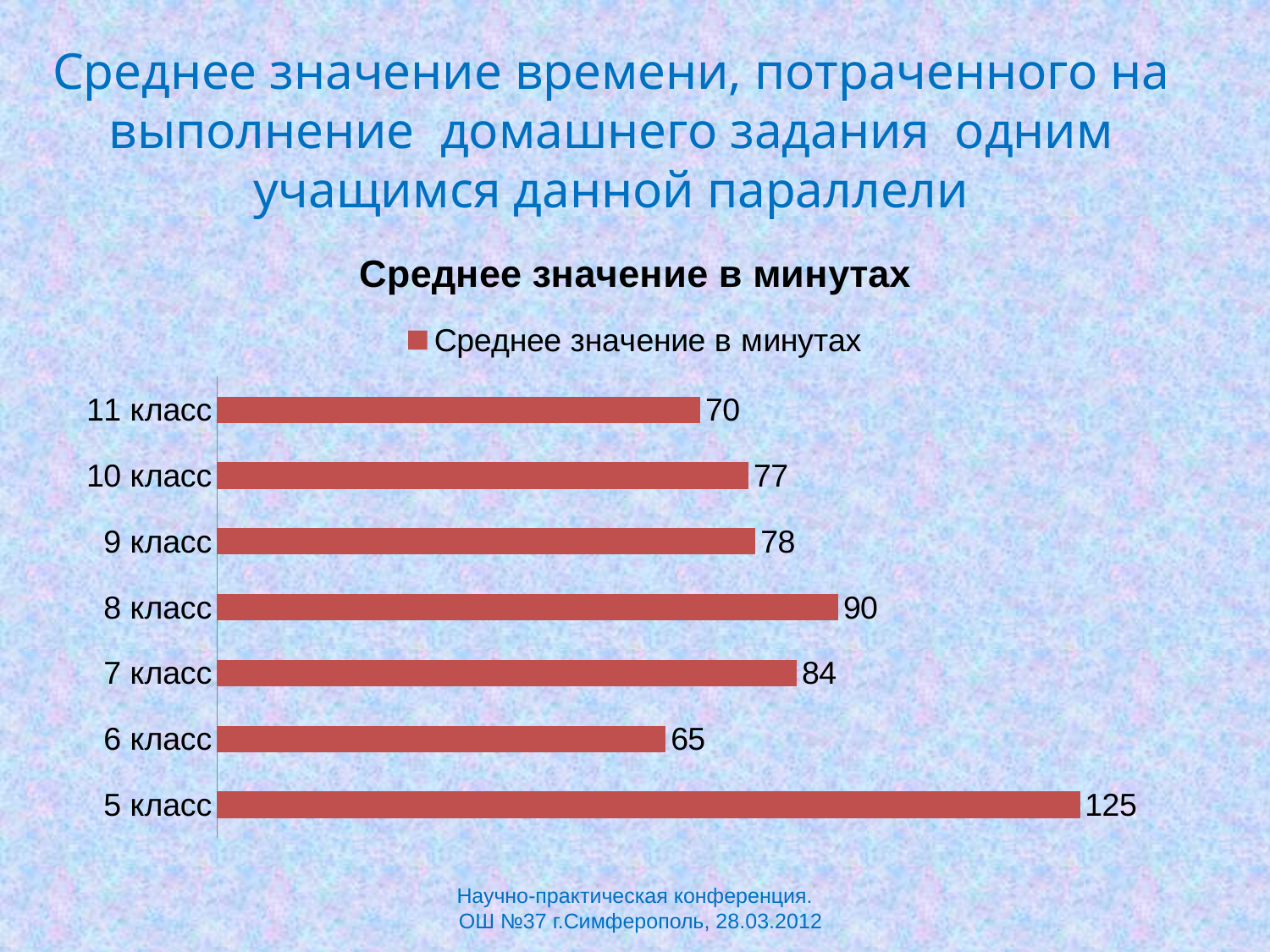
What is the title of the chart? Среднее значение в минутах What is the difference between the values for 5 класс and 6 класс? 60 Which class has the highest average value in minutes? 5 класс What is the difference between the values for 8 класс and 7 класс? 6 Which is larger, the value for 7 класс or the value for 10 класс? 7 класс What is the value for 5 класс? 125 What kind of chart is shown on the slide? bar chart Which class has the lowest average value in minutes? 6 класс What is the value for 8 класс? 90 How many classes are shown in the chart? 7 How many series does the legend list? 1 What is the value for 11 класс? 70